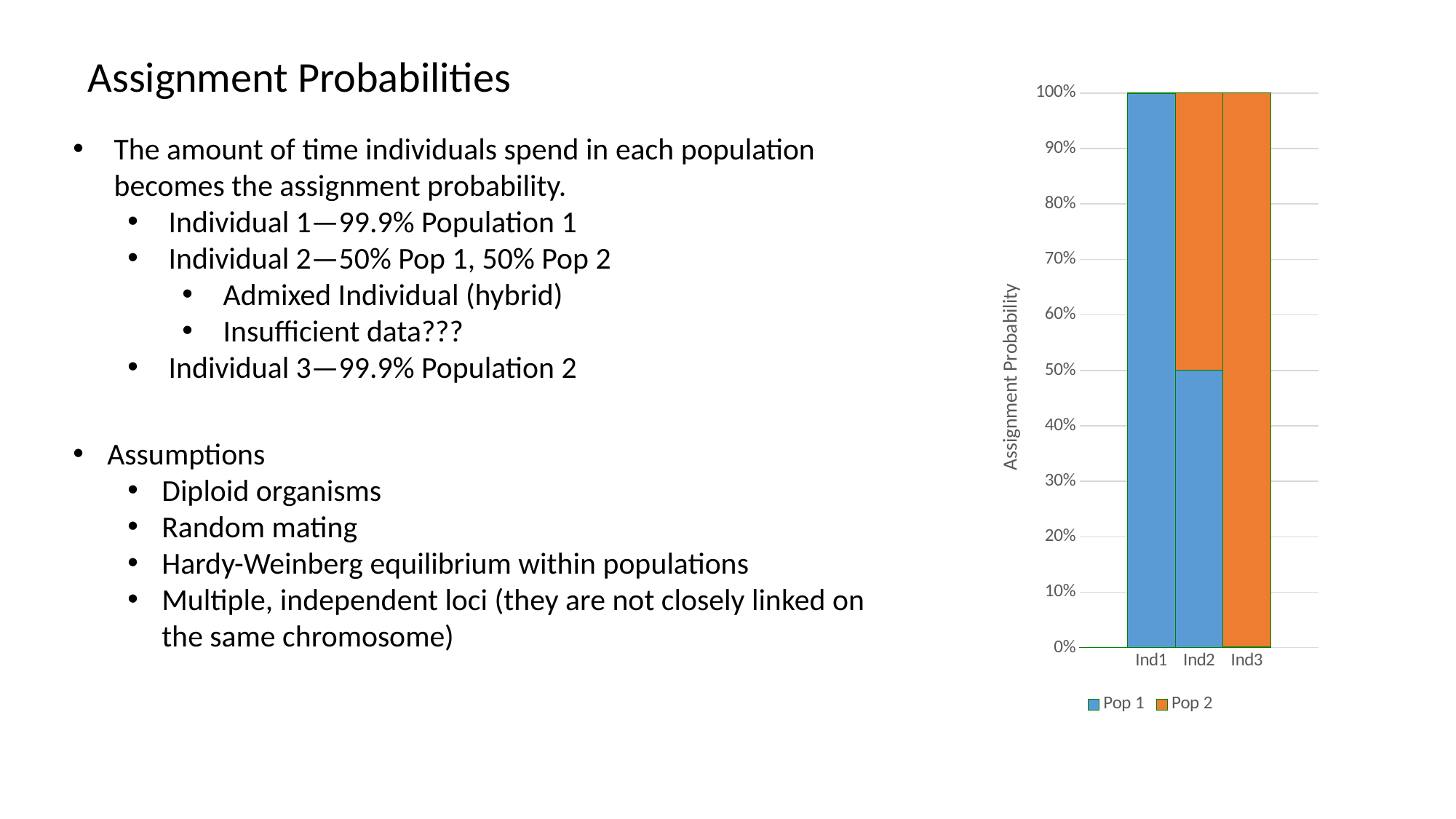
What is the Pop 1 assignment probability for Ind2 in the chart? 50% Is the Pop 1 assignment probability for Ind1 greater or less than 90%? greater What is the title of the chart's y axis? Assignment Probability Which individual has the larger Pop 1 assignment probability, Ind1 or Ind2? Ind1 How many series does the chart legend list? 2 Which individual has the highest Pop 1 assignment probability? Ind1 Is the Pop 2 assignment probability for Ind3 greater or less than 90%? greater How many individuals (categories) are plotted on the x axis of the chart? 3 What kind of chart is shown on the slide? Stacked bar chart Is the Pop 1 assignment probability for Ind3 greater or less than 10%? less Which individual has the lowest Pop 1 assignment probability? Ind3 Does the Pop 1 assignment probability rise or fall from Ind1 to Ind3? fall